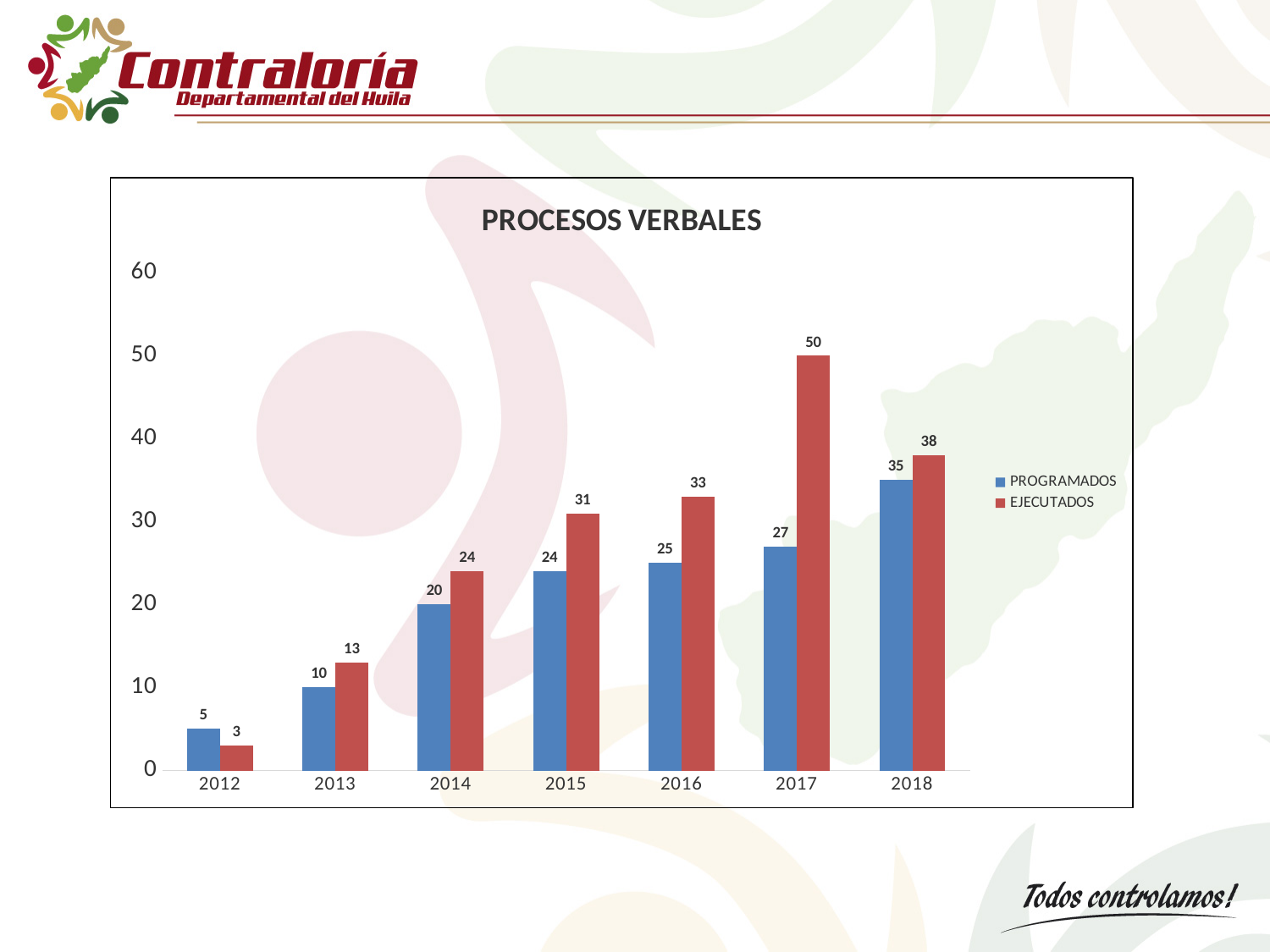
How many series does the legend list? 2 What is the title of the chart? PROCESOS VERBALES How many years are shown on the x axis? 7 What is the PROGRAMADOS value for 2014? 20 Which year has the highest EJECUTADOS value? 2017 What type of chart is shown on the slide? Bar chart What is the EJECUTADOS value for 2012? 3 In 2012, which is larger, PROGRAMADOS or EJECUTADOS? PROGRAMADOS What is the difference between EJECUTADOS and PROGRAMADOS in 2017? 23 Which year has the lowest PROGRAMADOS value? 2012 Do the PROGRAMADOS values rise or fall from 2012 to 2018? Rise What is the EJECUTADOS value for 2017? 50